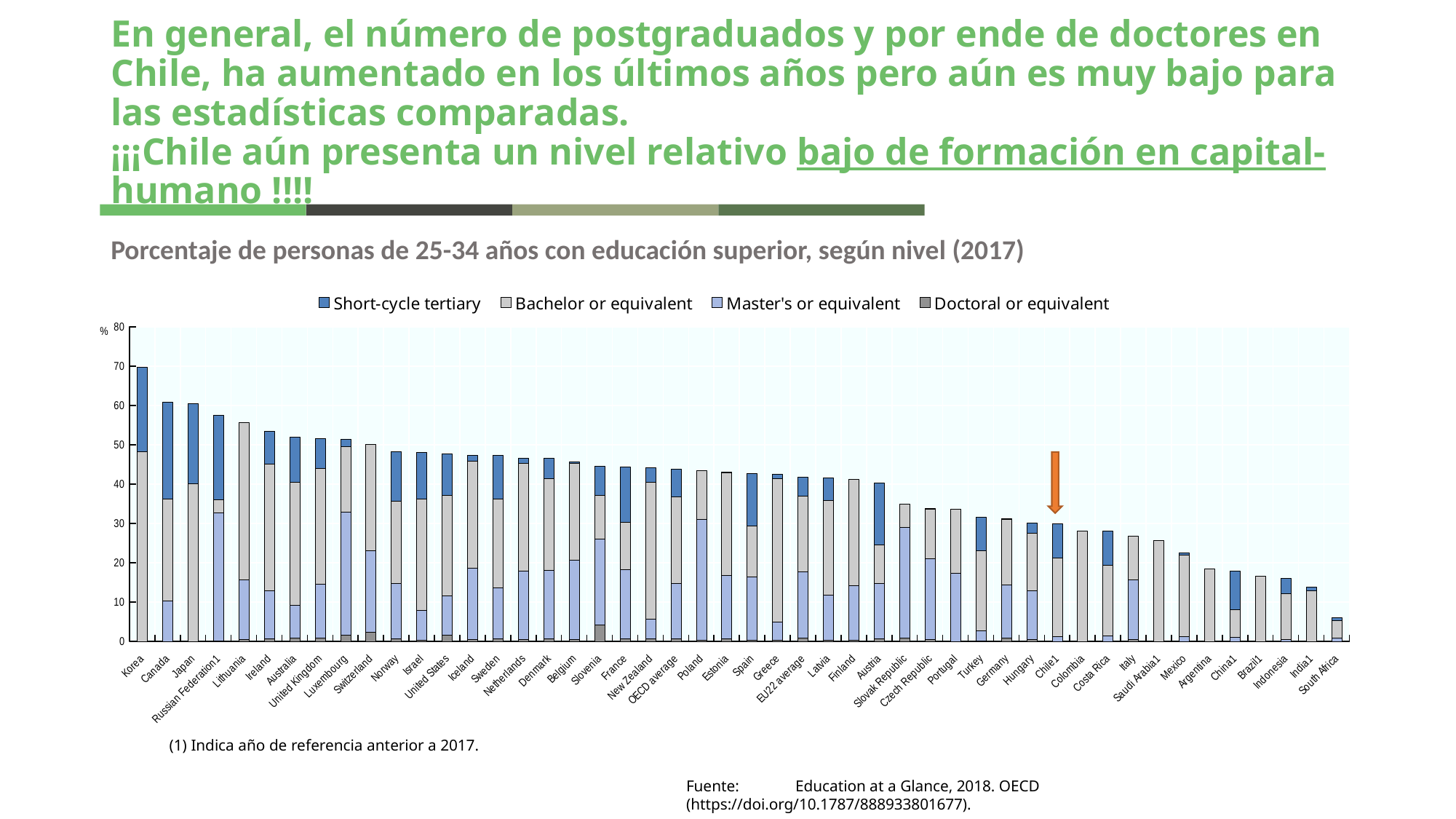
Which country's bar is marked with the orange arrow? Chile1 Is the total value for Chile1 greater or less than 40? less How many series does the legend list? 4 Which country has the lowest total bar in the chart? South Africa Is the total value for Korea greater or less than 60? greater Is the total value for South Africa greater or less than 10? less Which country has the highest total bar in the chart? Korea Which has a larger total bar, Korea or Chile1? Korea What kind of chart is shown on the slide? Stacked bar chart Which has a larger total bar, Poland or Mexico? Poland Which series is listed first in the legend? Short-cycle tertiary Do the total bar values generally rise or fall from left to right along the x axis? Fall